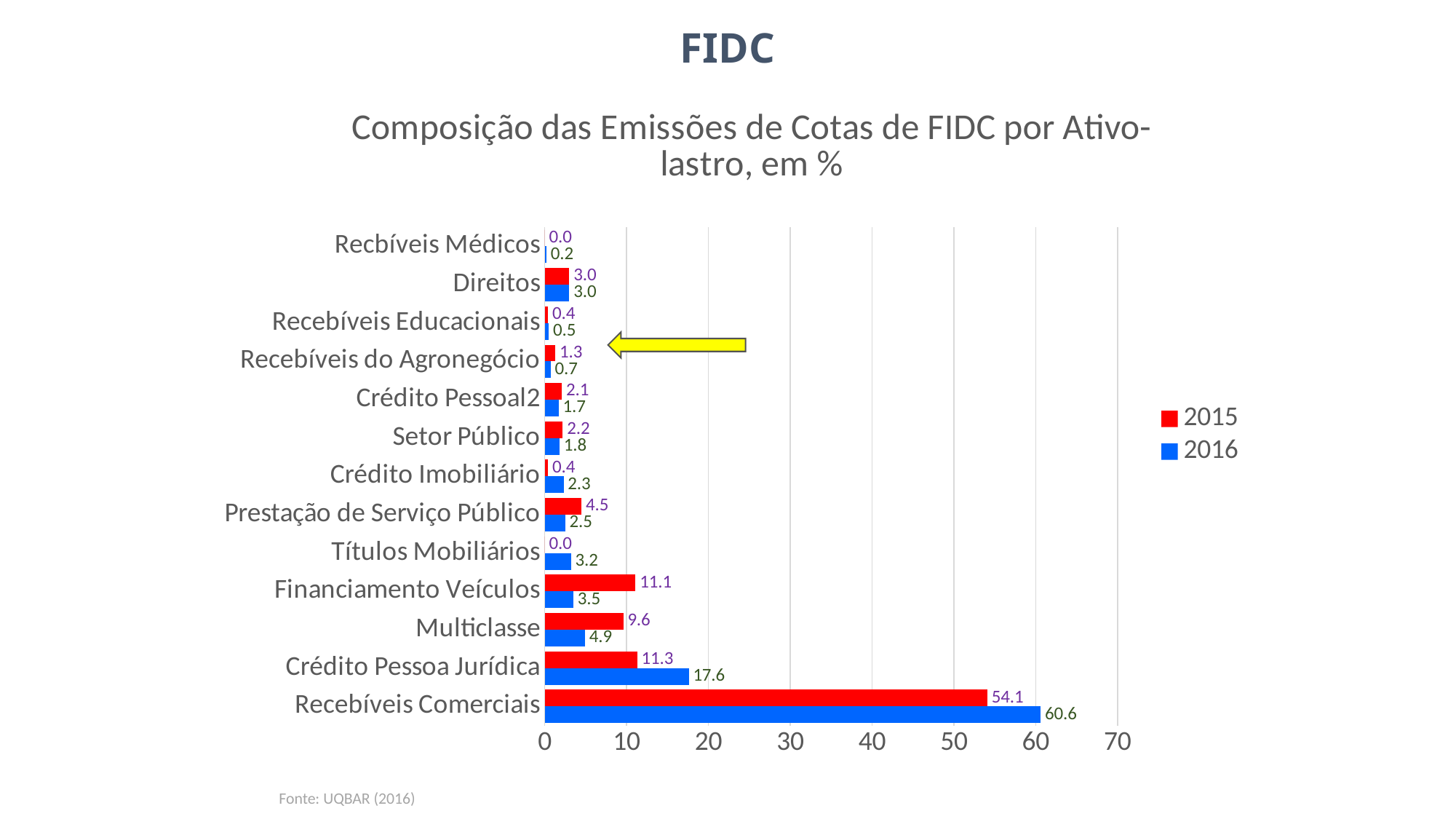
Which category has the lowest 2016 value? Recbíveis Médicos What is the difference between the 2016 and 2015 values for Recebíveis Comerciais? 6.5 Which is larger for Multiclasse, the 2015 value or the 2016 value? 2015 What is the 2016 value for Crédito Pessoa Jurídica? 17.6 How many categories are shown on the chart? 13 What is the 2015 value for Títulos Mobiliários? 0.0 Is the 2015 value for Recebíveis Comerciais greater or less than 50? greater What is the 2016 value for Recebíveis Comerciais? 60.6 What kind of chart is shown on the slide? Bar chart Which category has the highest 2015 value? Recebíveis Comerciais How many series does the legend list? 2 What is the 2015 value for Financiamento Veículos? 11.1